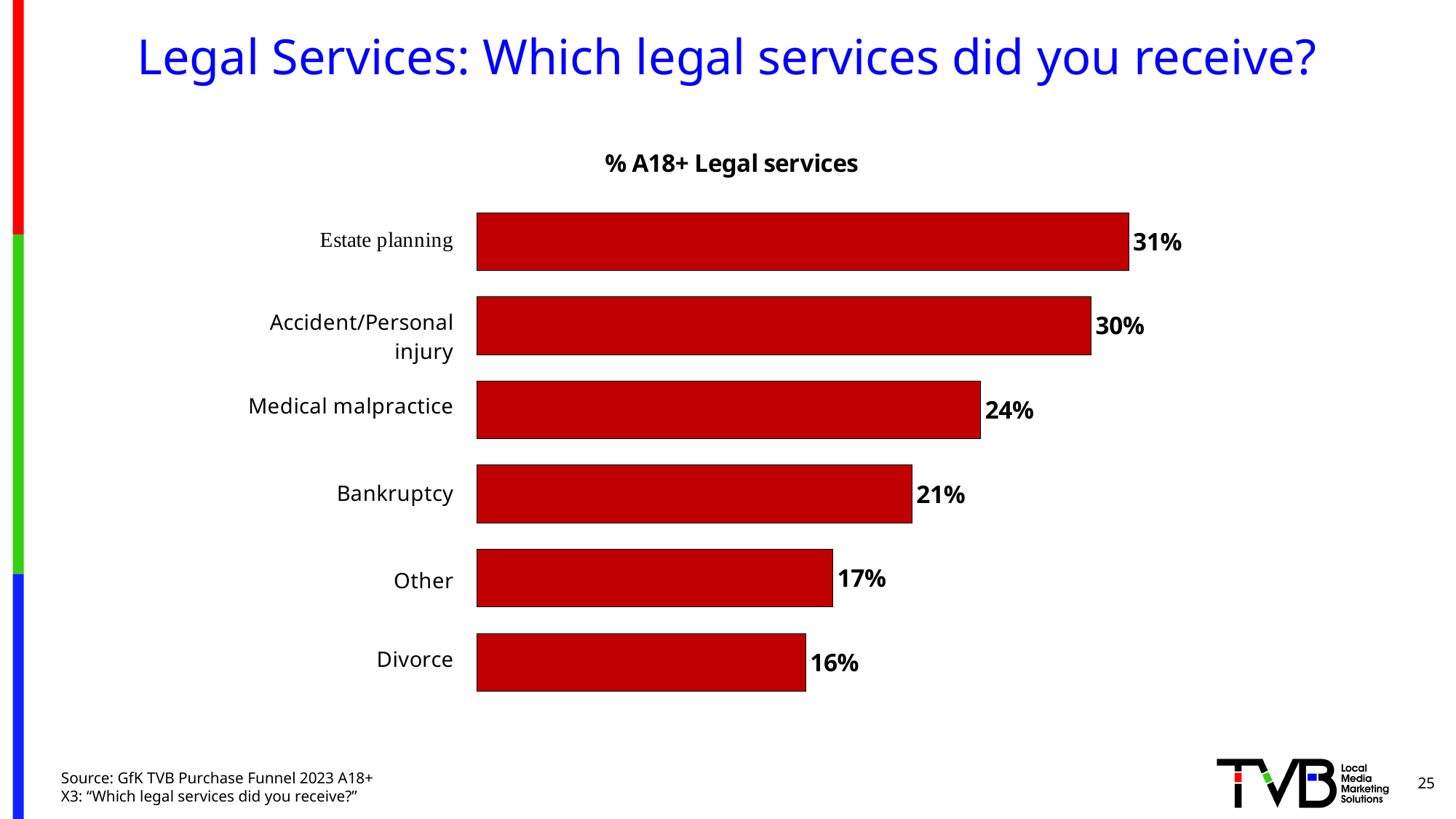
What type of chart is shown on the slide? Bar chart What is the value shown for Bankruptcy? 21% What is the difference in percentage points between Estate planning and Divorce? 15 Which legal service has the lowest percentage? Divorce What is the difference in percentage points between Accident/Personal injury and Medical malpractice? 6 What is the title of the chart? % A18+ Legal services How many legal service categories are shown in the chart? 6 What is the value shown for Divorce? 16% Which is larger, the value for Bankruptcy or the value for Other? Bankruptcy Which legal service has the highest percentage? Estate planning What percentage of A18+ received estate planning legal services? 31% What is the value shown for Medical malpractice? 24%